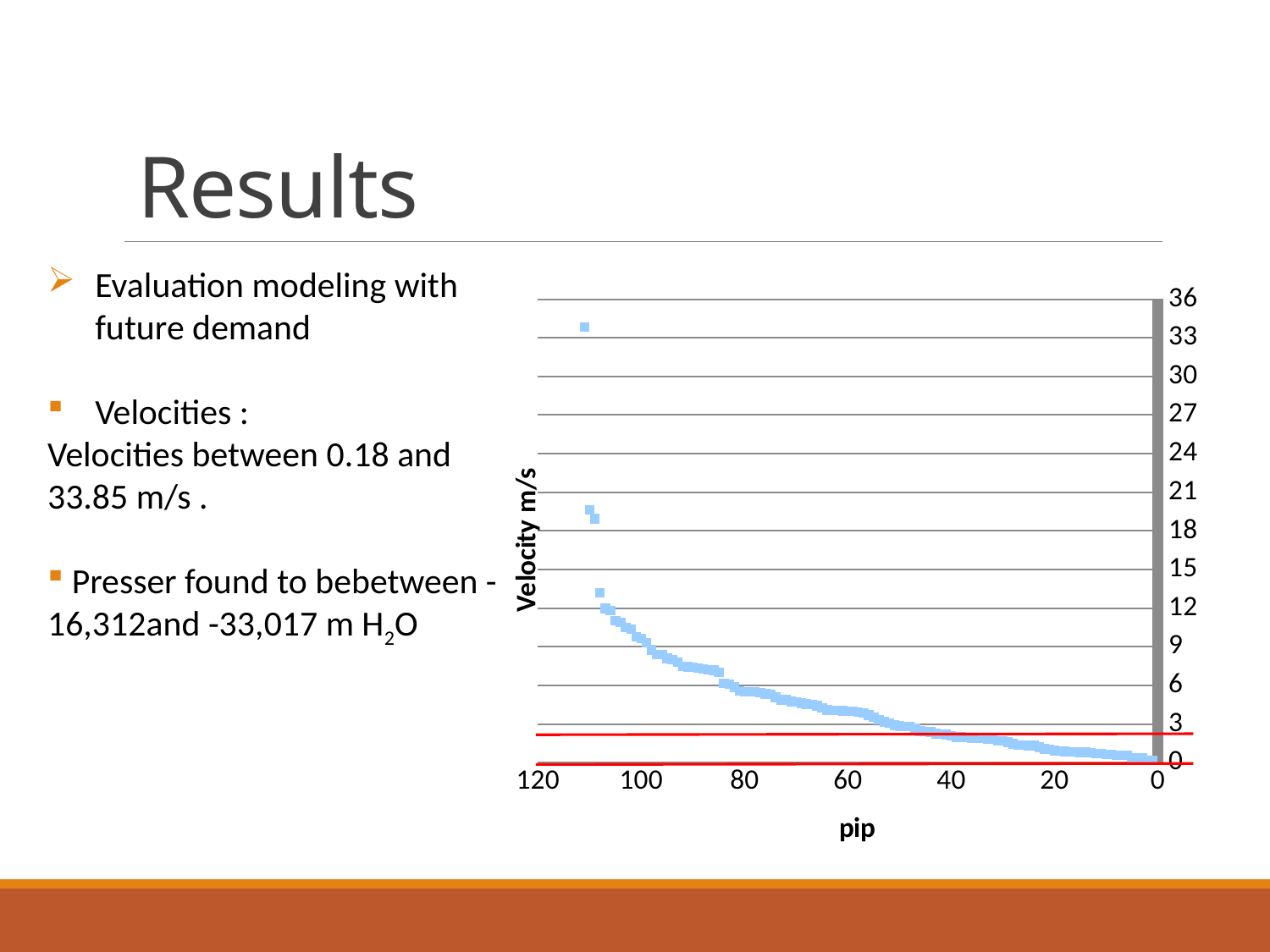
Is the velocity value at pip 20 greater or less than 3? less What kind of chart is shown on the slide? scatter chart What is the leftmost tick value shown on the horizontal axis? 120 What is the title of the horizontal axis of the chart? pip Is the velocity value at pip 40 greater or less than 6? less Is the velocity value at pip 60 greater or less than 6? less What is the title of the vertical axis of the chart? Velocity m/s Moving from left to right along the horizontal axis, do the plotted velocity values rise or fall? fall What is the highest tick value shown on the vertical axis? 36